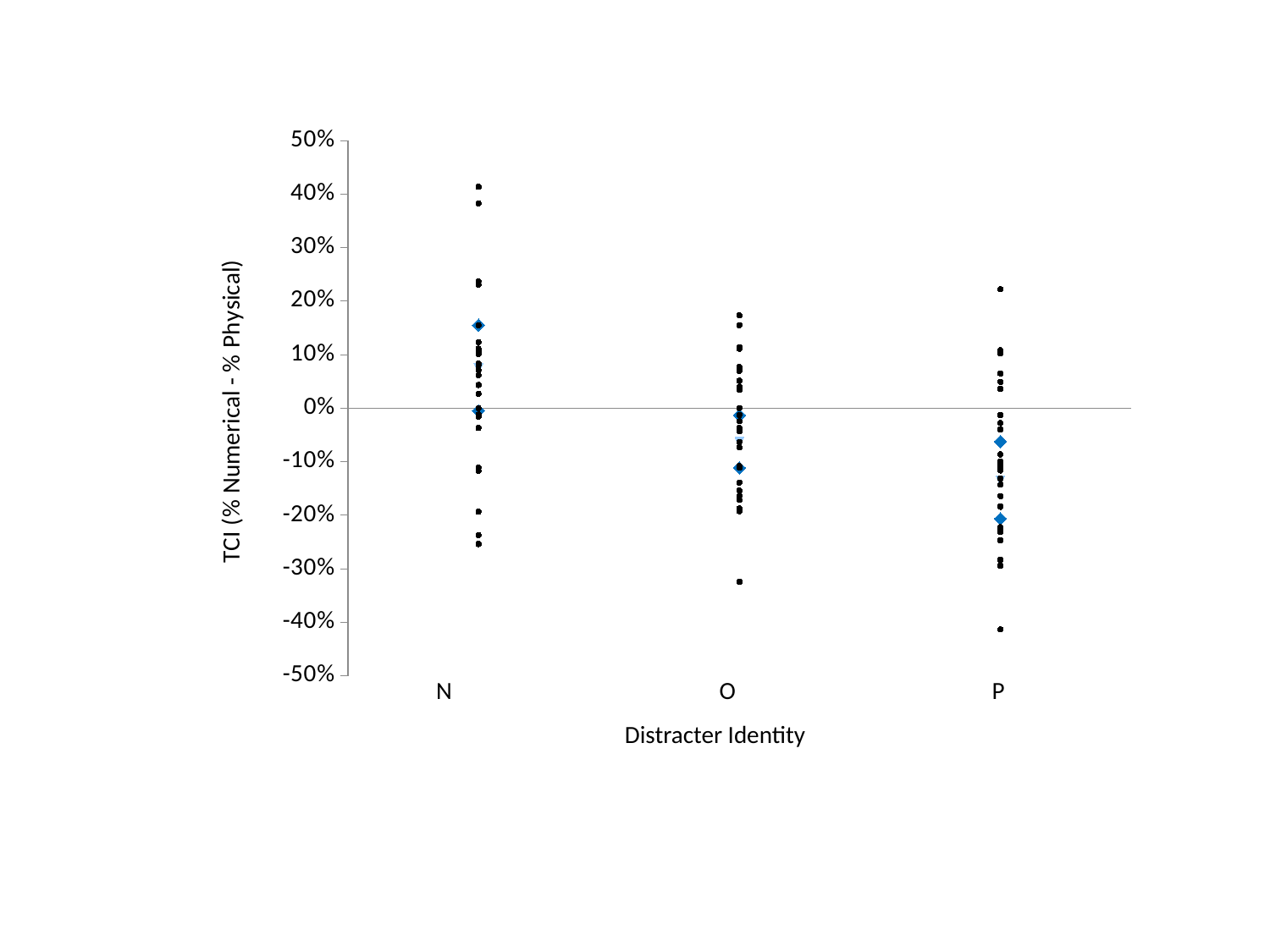
What are the minimum and maximum values shown on the y axis? -50% and 50% Is the highest data point for category P greater or less than 20%? greater Is the lowest data point for category N greater or less than -30%? greater What is the title of the y axis? TCI (% Numerical - % Physical) What is the title of the x axis? Distracter Identity Is the highest data point for category O greater or less than 20%? less Which category contains the lowest single data point? P What kind of chart is shown on the slide? scatter plot Which category contains the highest single data point? N How many distracter identity categories are shown on the x axis? 3